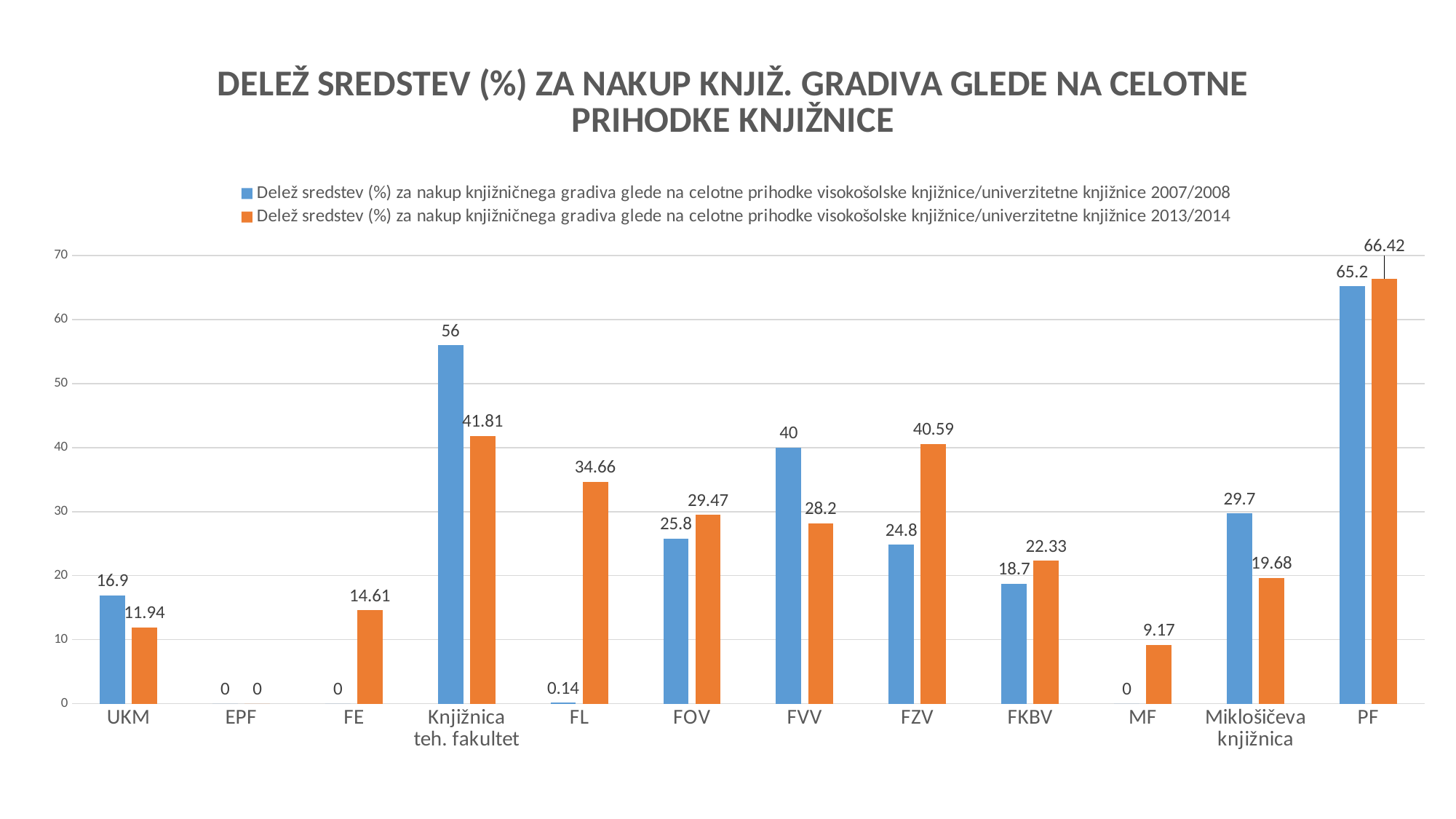
What is the 2007/2008 value for Miklošičeva knjižnica? 29.7 What kind of chart is shown on the slide? Bar chart What is the 2013/2014 value for FL? 34.66 Which category has the highest 2007/2008 value? PF For FOV, which is larger: the 2007/2008 value or the 2013/2014 value? 2013/2014 What is the 2007/2008 value for Knjižnica teh. fakultet? 56 How many categories are shown on the x axis? 12 How many series does the legend list? 2 What is the difference between the 2013/2014 values for FZV and FVV? 12.39 What is the difference between the 2007/2008 and 2013/2014 values for Knjižnica teh. fakultet? 14.19 What is the 2013/2014 value for MF? 9.17 Which category has the highest 2013/2014 value? PF